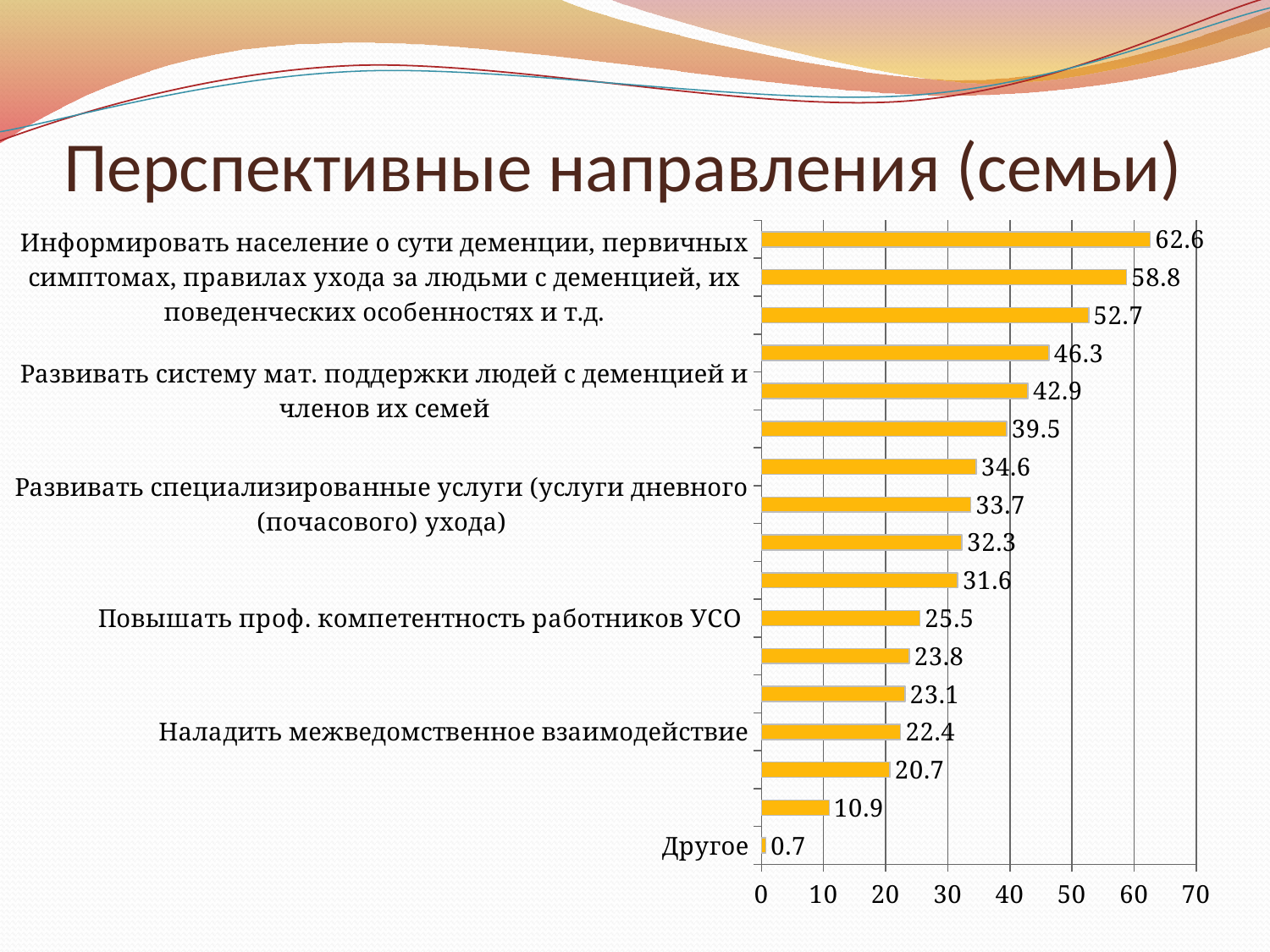
What is the title of the chart on the slide? Перспективные направления (семьи) What is the largest value shown in the chart? 62.6 What is the value for "Другое"? 0.7 What is the value for "Наладить межведомственное взаимодействие"? 22.4 How many bars are plotted in the chart? 17 What type of chart is shown on the slide? bar chart Which is larger: the value for "Повышать проф. компетентность работников УСО" or the value for "Наладить межведомственное взаимодействие"? Повышать проф. компетентность работников УСО What is the value for "Развивать систему мат. поддержки людей с деменцией и членов их семей"? 42.9 What is the difference between the values for "Развивать систему мат. поддержки людей с деменцией и членов их семей" and "Развивать специализированные услуги (услуги дневного (почасового) ухода)"? 9.2 What is the value for "Повышать проф. компетентность работников УСО"? 25.5 Which category has the lowest value? Другое What is the value for "Развивать специализированные услуги (услуги дневного (почасового) ухода)"? 33.7